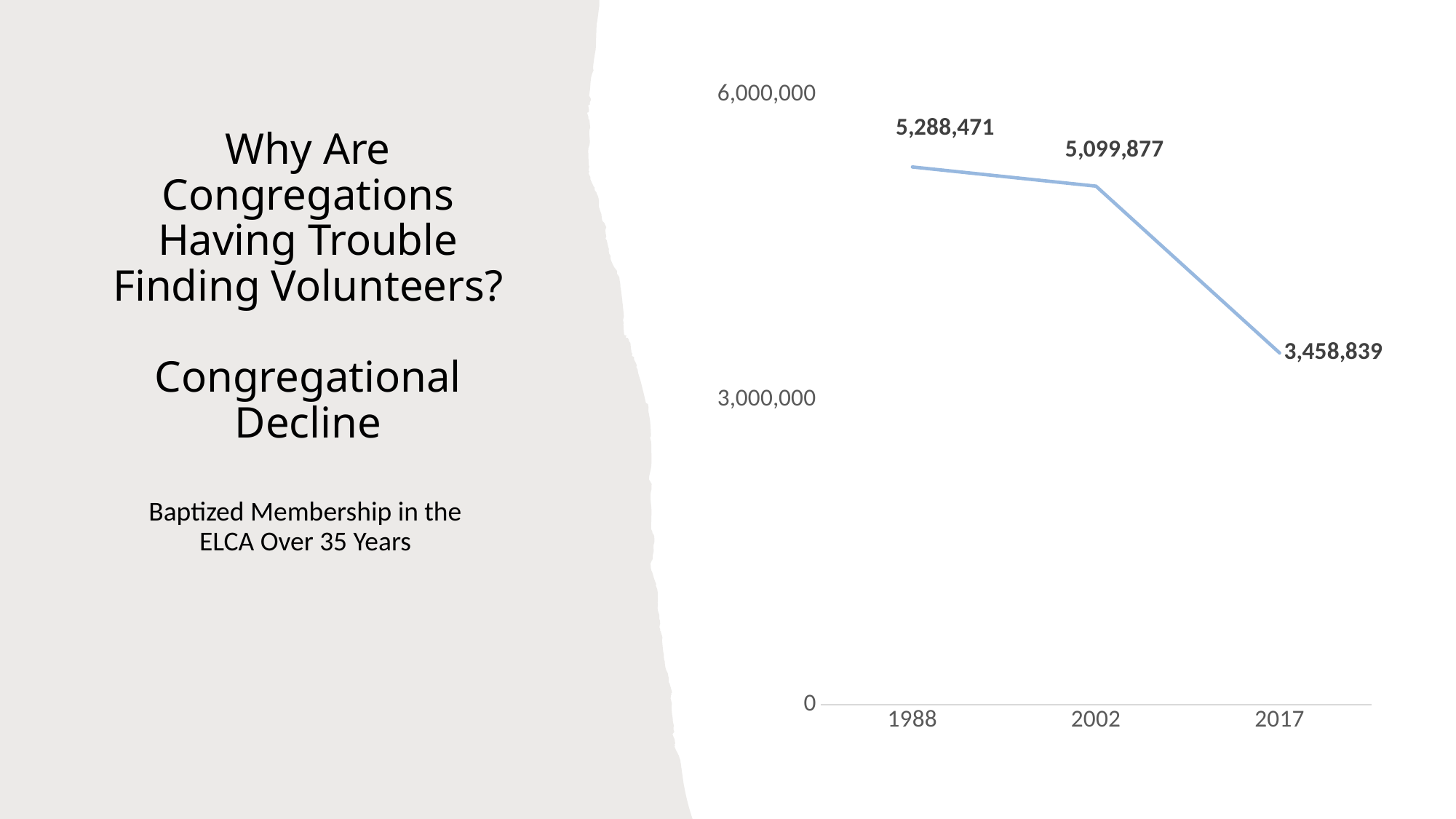
What is the difference between the values for 1988 and 2017? 1,829,632 What is the difference between the values for 2002 and 2017? 1,641,038 Which year has the highest value on the chart? 1988 Which is larger, the value for 2002 or the value for 2017? 2002 What is the value plotted for 1988? 5,288,471 What is the value plotted for 2002? 5,099,877 How many data points are plotted on the chart? 3 What kind of chart is shown on the slide? line chart Which year has the lowest value on the chart? 2017 What is the difference between the values for 1988 and 2002? 188,594 Is the value for 2017 greater or less than 3,000,000? greater What is the value plotted for 2017? 3,458,839